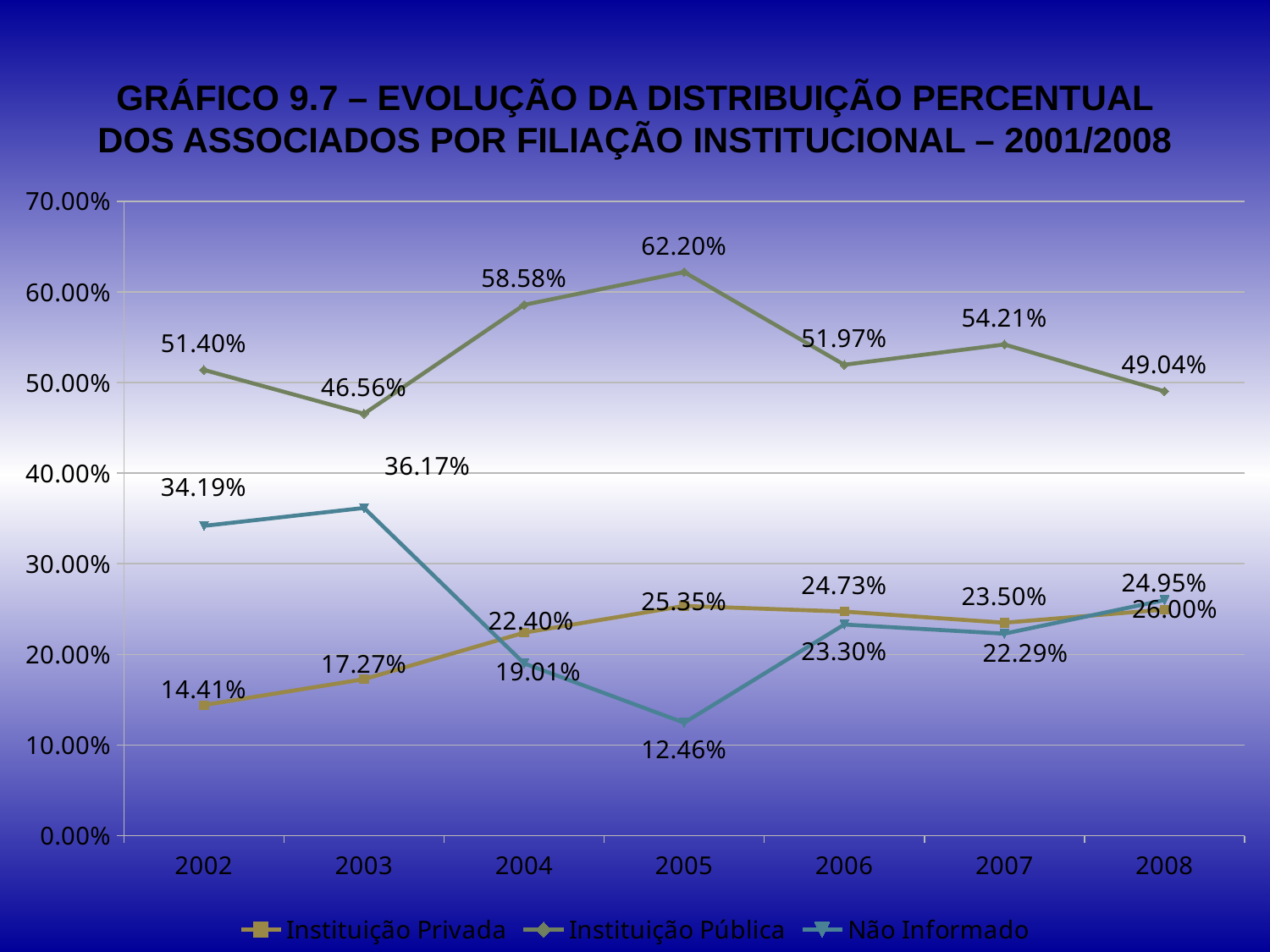
Does the Instituição Privada value rise or fall from 2002 to 2005? Rise How many series does the legend list? 3 What is the value for Instituição Pública in 2005? 62.20% How many years are shown on the x axis? 7 Which is larger in 2003: Instituição Privada or Não Informado? Não Informado What is the value for Não Informado in 2004? 19.01% What kind of chart is shown on the slide? Line chart What is the difference between the Instituição Pública values in 2005 and 2003? 15.64% In which year does Instituição Pública reach its highest value? 2005 What is the value for Instituição Privada in 2002? 14.41% In which year is the Não Informado value lowest? 2005 What is the value for Não Informado in 2005? 12.46%